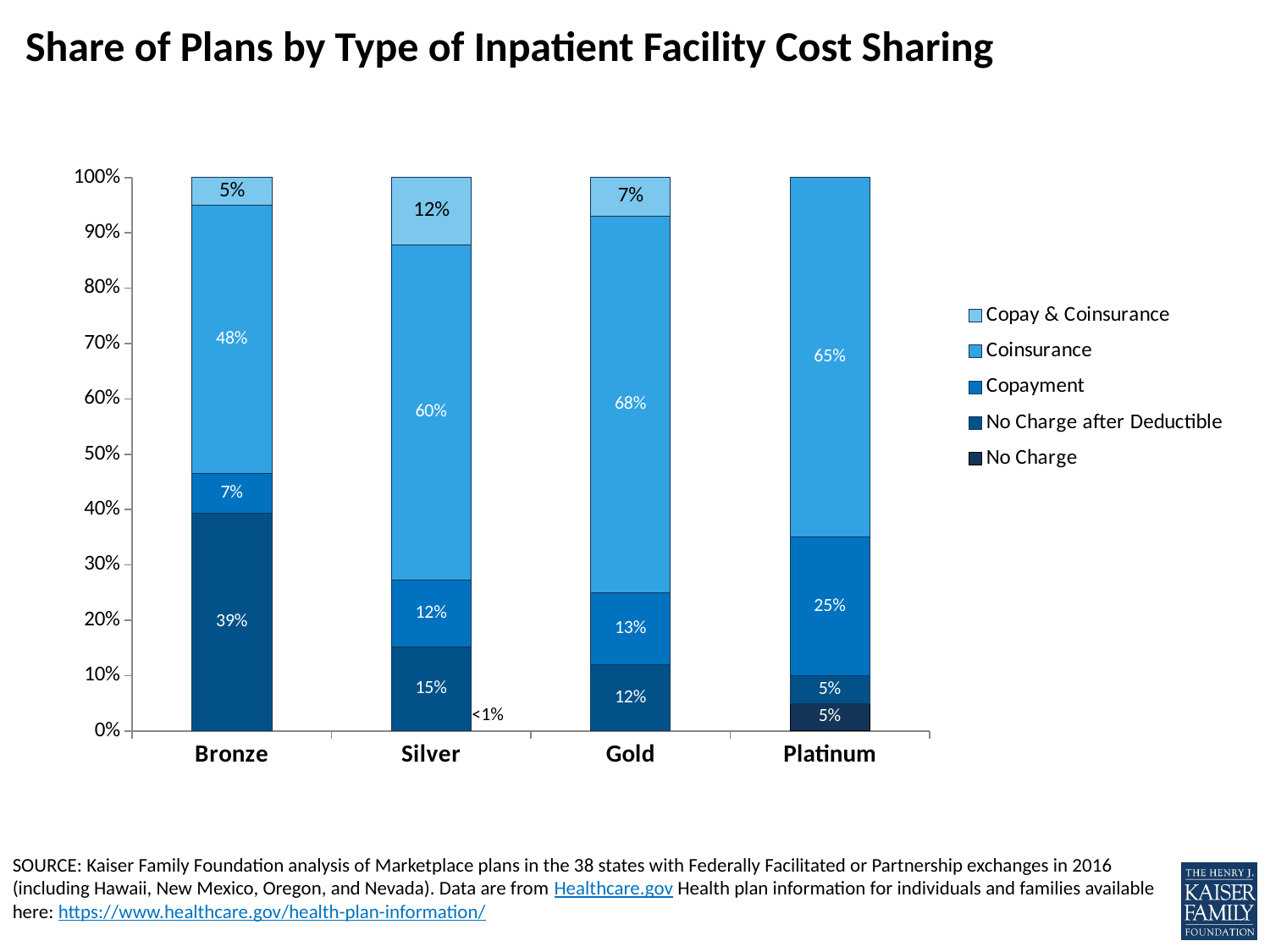
How much larger is the Coinsurance share for Gold plans than for Bronze plans? 20 percentage points Which has a larger Copayment share, Gold or Silver? Gold What kind of chart is shown on the slide? Stacked bar chart Which plan type has the lowest Copayment share? Bronze What is the title of the chart? Share of Plans by Type of Inpatient Facility Cost Sharing Which plan type has the highest Coinsurance share? Gold How many series does the legend list? 5 What share of Bronze plans have No Charge after Deductible? 39% What is the Copay & Coinsurance share for Silver plans? 12% How many plan types are shown on the x axis? 4 What share of Gold plans have Coinsurance for inpatient facility cost sharing? 68% What is the Copayment share for Platinum plans? 25%